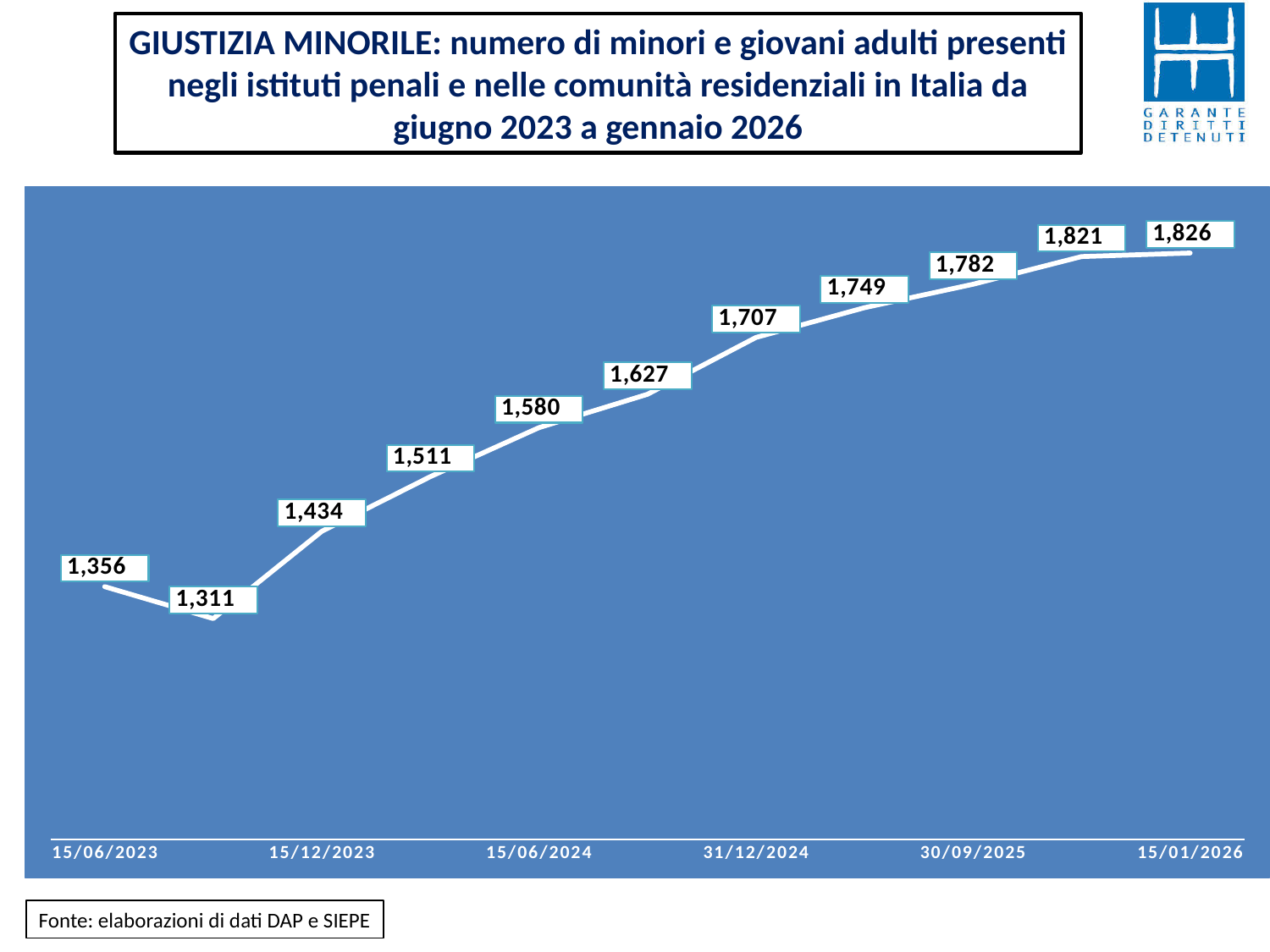
What is the highest value shown on the line? 1,826 What is the value plotted for 30/09/2025? 1,782 What is the difference between the value for 15/01/2026 and the value for 15/06/2023? 470 What is the value plotted for 15/06/2023? 1,356 What type of chart is shown on the slide? line chart Which is larger, the value for 15/12/2023 or the value for 15/06/2024? 15/06/2024 How many data points are labelled on the line? 11 What is the value plotted for 15/01/2026? 1,826 Overall, do the values rise or fall from 15/06/2023 to 15/01/2026? rise What is the value plotted for 31/12/2024? 1,707 According to the note below the chart, what is the source of the data? elaborazioni di dati DAP e SIEPE What is the lowest value shown on the line? 1,311